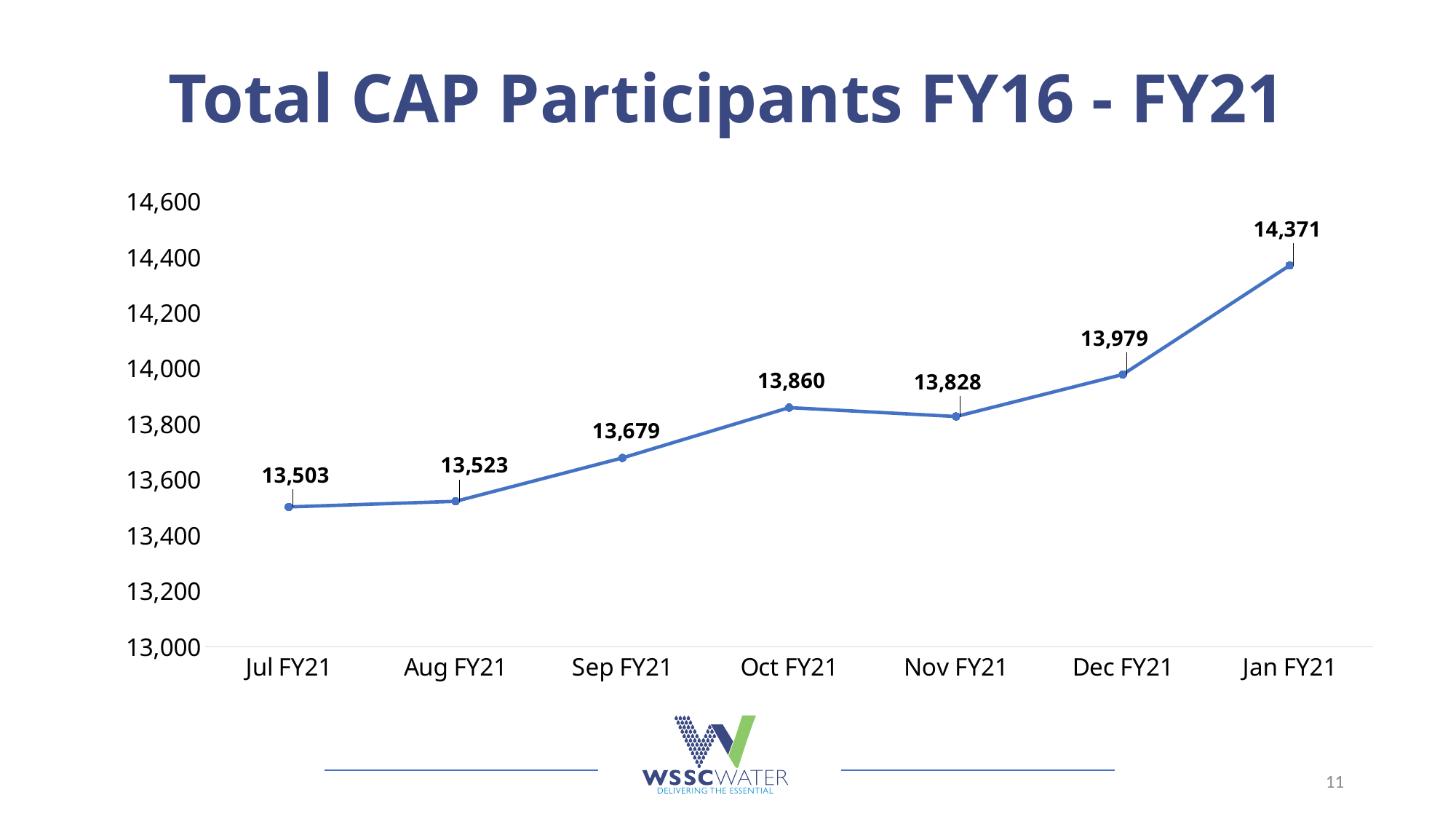
How many data points are plotted on the chart? 7 Which month has the highest value? Jan FY21 Is the value for Dec FY21 greater or less than 14,000? less What is the difference between the values for Oct FY21 and Nov FY21? 32 Which is larger, the value for Sep FY21 or the value for Nov FY21? Nov FY21 What is the value for Jan FY21? 14,371 What is the title of the chart? Total CAP Participants FY16 - FY21 What kind of chart is shown on the slide? line chart Which month has the lowest value? Jul FY21 What is the value for Jul FY21? 13,503 What is the value for Oct FY21? 13,860 What is the difference between the values for Jan FY21 and Dec FY21? 392